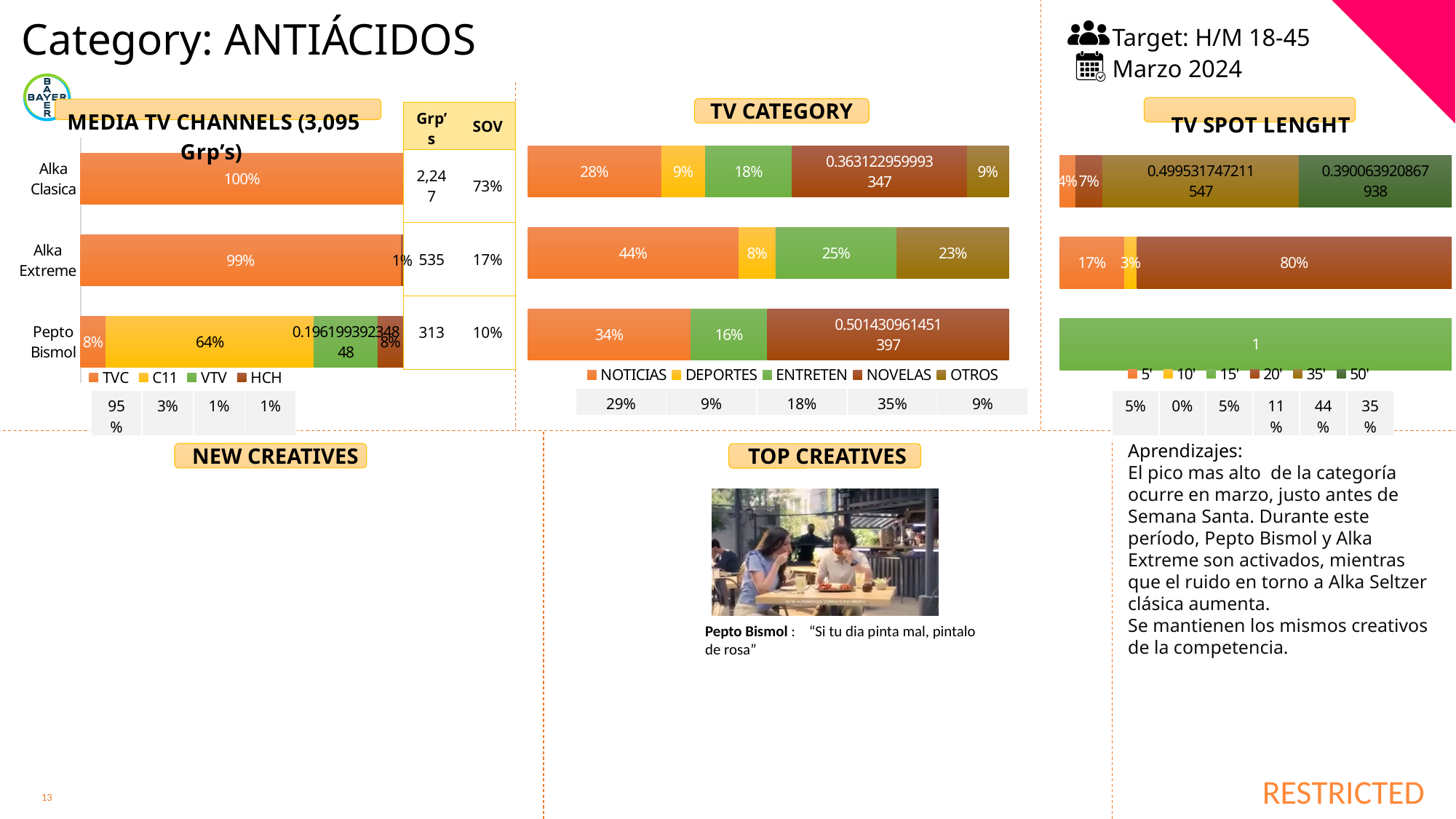
In the MEDIA TV CHANNELS chart, what is the C11 value for Pepto Bismol? 64% In the TV CATEGORY chart, what is the difference between the NOTICIAS and ENTRETEN values of the middle bar? 19 percentage points In the TV CATEGORY chart, what is the NOTICIAS value for the middle bar? 44% In the TV SPOT LENGHT chart, what is the 20' value for the middle bar? 80% How many series does the legend of the MEDIA TV CHANNELS chart list? 4 How many series does the legend of the TV CATEGORY chart list? 5 In the TV CATEGORY chart, what is the ENTRETEN value for the middle bar? 25% What kind of chart is the MEDIA TV CHANNELS chart? bar chart In the MEDIA TV CHANNELS chart, what is the TVC value for Alka Clasica? 100% In the TV CATEGORY chart, which is larger for the top bar: NOTICIAS or ENTRETEN? NOTICIAS How many series does the legend of the TV SPOT LENGHT chart list? 6 How many brands (categories) are shown in the MEDIA TV CHANNELS chart? 3